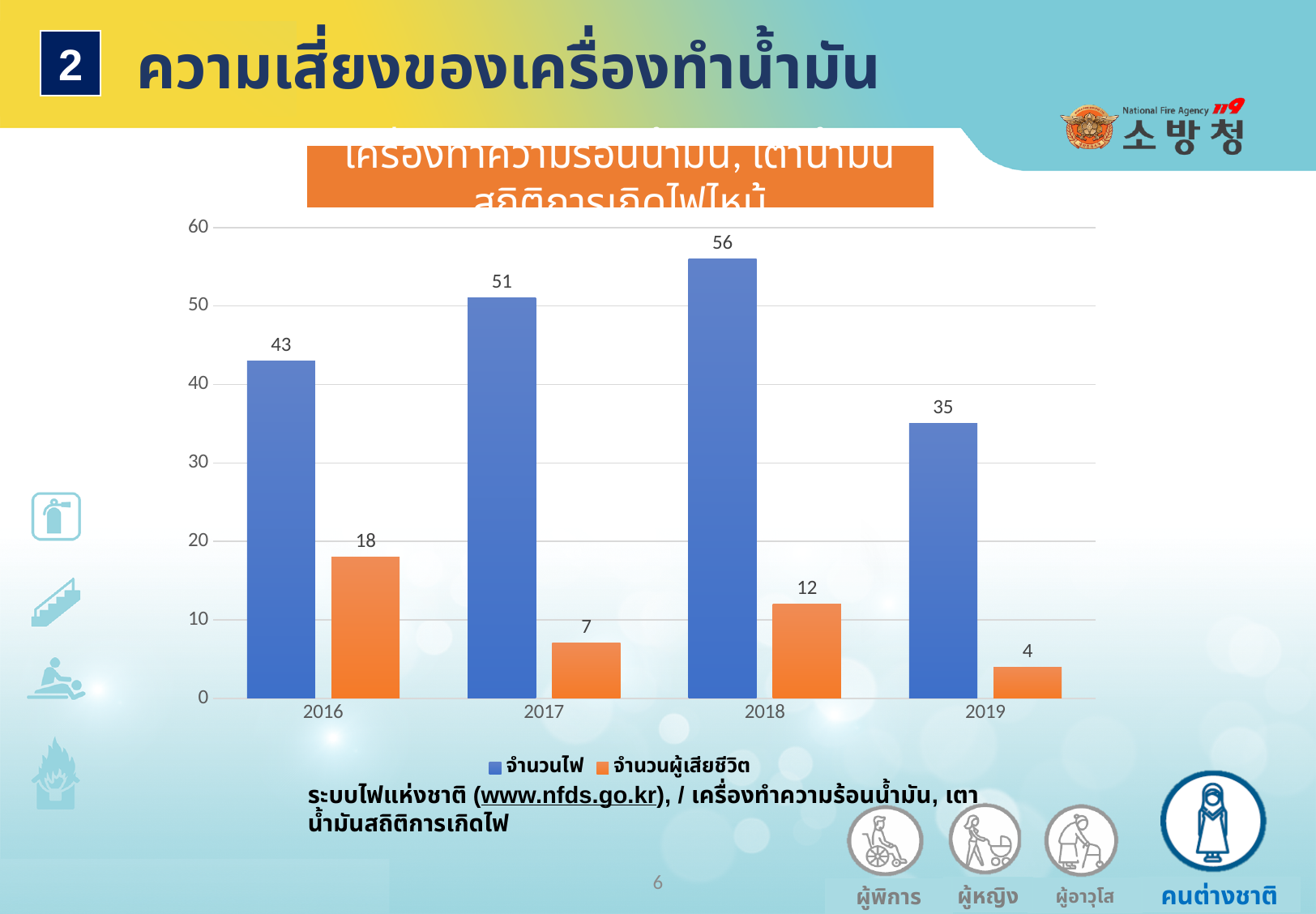
Which is larger, the จำนวนผู้เสียชีวิต value for 2017 or for 2018? 2018 What kind of chart is shown on the slide? bar chart Which year has the lowest value for จำนวนผู้เสียชีวิต? 2019 What is the value of จำนวนไฟ for 2018? 56 What is the value of จำนวนไฟ for 2019? 35 How many series does the legend list? 2 How many years are shown on the x axis? 4 Is the value for จำนวนไฟ in 2016 greater or less than 40? greater Which colour represents จำนวนผู้เสียชีวิต in the chart? orange Which year has the highest value for จำนวนไฟ? 2018 What is the value of จำนวนผู้เสียชีวิต for 2016? 18 What is the difference between the จำนวนไฟ values for 2017 and 2016? 8